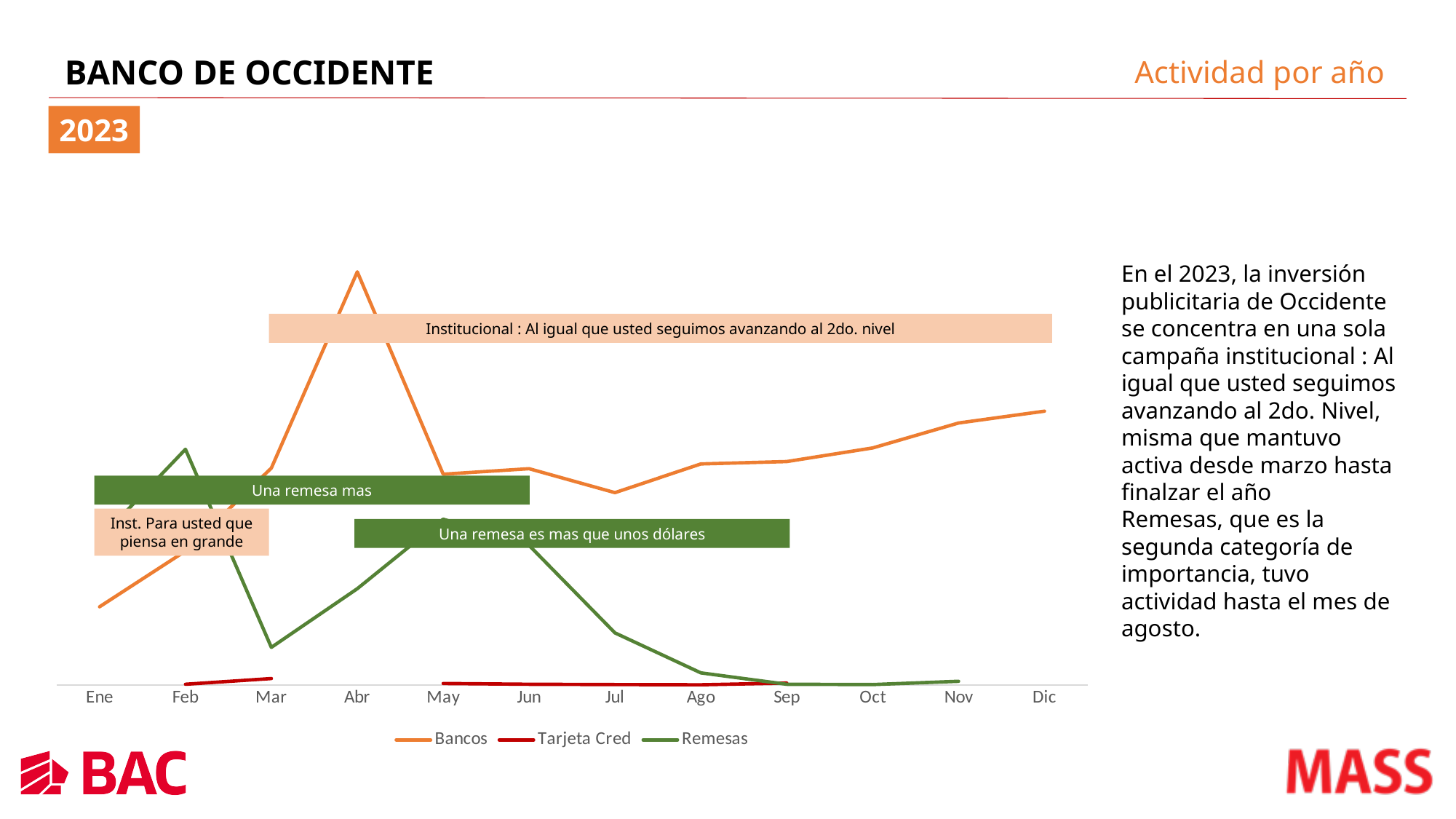
In which month does the Bancos series reach its highest value? Abr In which month does the Bancos series have its lowest value? Ene What kind of chart is shown on the slide? Line chart What colour is the line for the Remesas series? Green How many series does the chart legend list? 3 In which month does the Remesas series reach its highest value? Feb Does the Remesas series rise or fall from Jun to Sep? Fall In Feb, which series is higher, Bancos or Remesas? Remesas Does the Bancos series rise or fall from Jul to Dic? Rise How many months are shown along the x axis of the chart? 12